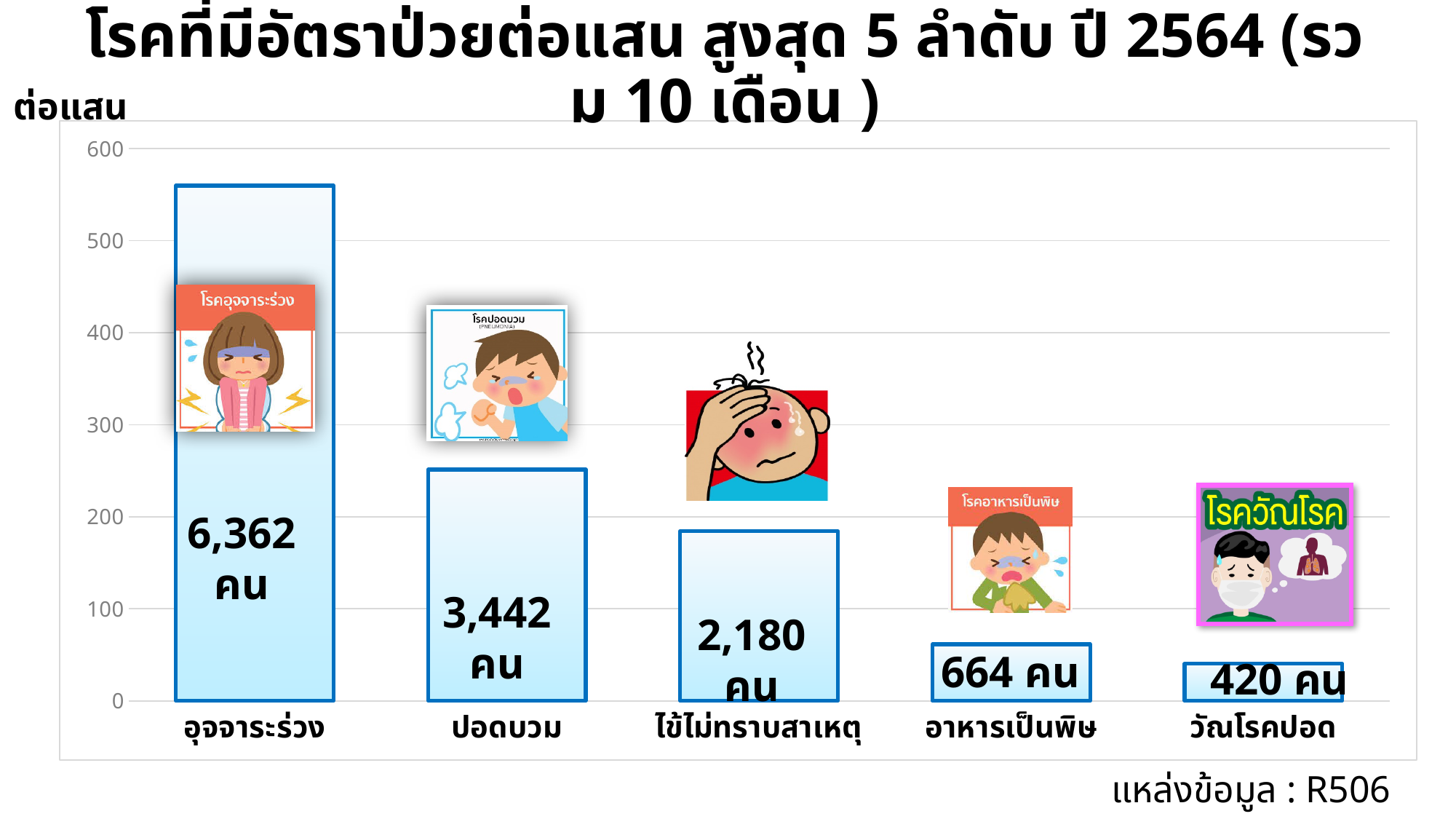
Which disease has the lowest bar? วัณโรคปอด Is the value for อุจจาระร่วง on the ต่อแสน axis greater or less than 500? greater What label is printed on the bar for อุจจาระร่วง? 6,362 คน What label is printed on the bar for ไข้ไม่ทราบสาเหตุ? 2,180 คน What is the difference between the labelled counts for อุจจาระร่วง and ปอดบวม? 2,920 คน Is the value for ปอดบวม on the ต่อแสน axis greater or less than 300? less Which disease has the highest bar? อุจจาระร่วง What label is printed on the bar for อาหารเป็นพิษ? 664 คน What label is printed on the bar for ปอดบวม? 3,442 คน Which is larger, the bar for ไข้ไม่ทราบสาเหตุ or the bar for อาหารเป็นพิษ? ไข้ไม่ทราบสาเหตุ How many diseases are shown on the chart? 5 What label is printed on the bar for วัณโรคปอด? 420 คน